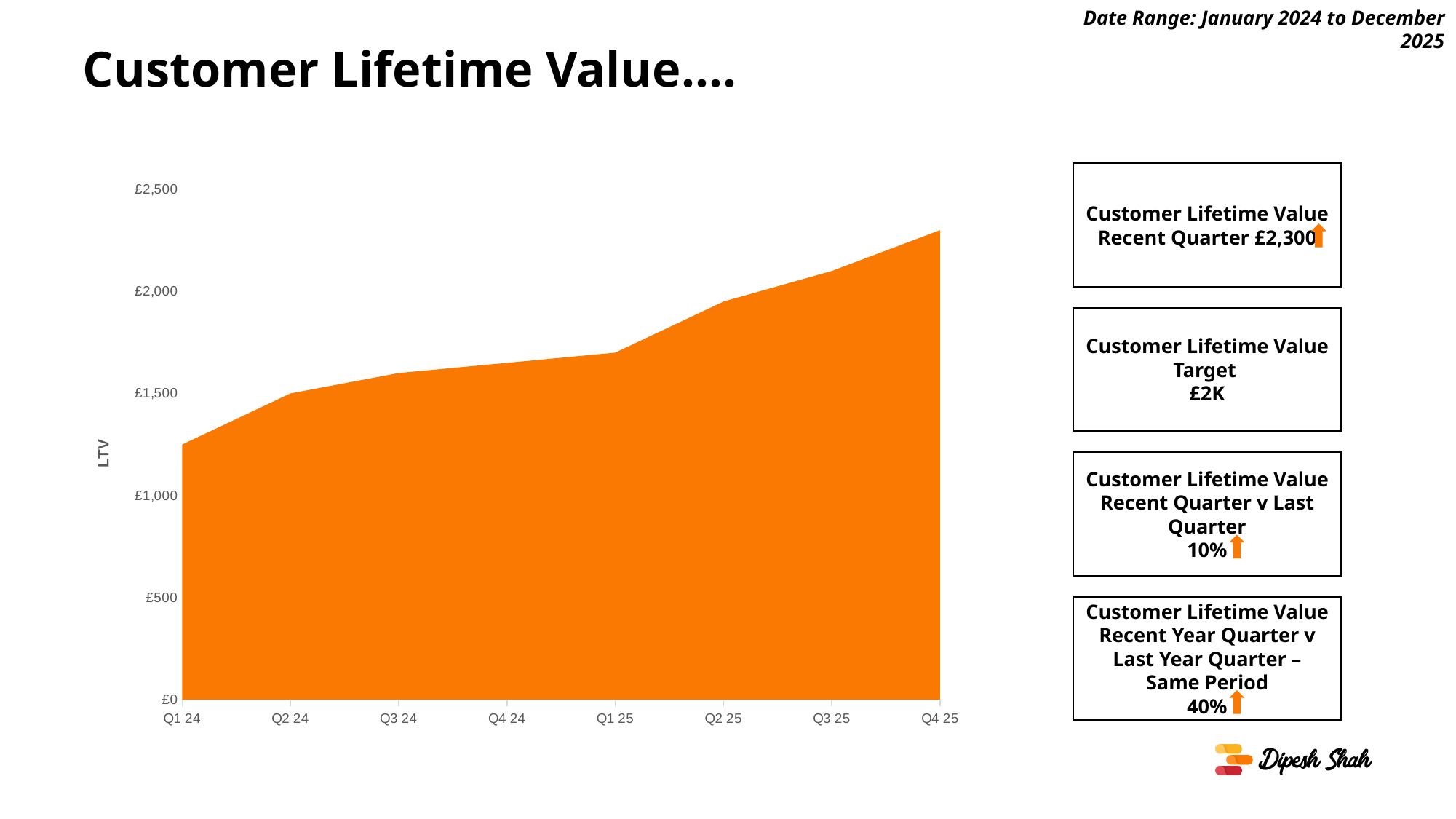
Is the LTV value for Q1 25 greater or less than £1,500? greater Is the LTV value for Q4 24 greater or less than £2,000? less Is the LTV value for Q1 24 greater or less than £1,000? greater Which quarter has the larger LTV, Q2 24 or Q3 25? Q3 25 How many quarters are plotted along the x axis of the chart? 8 What kind of chart is shown on the slide? Area chart Which quarter has the lowest LTV in the chart? Q1 24 What is the label on the y axis of the chart? LTV Do the LTV values rise or fall from Q1 24 to Q4 25? Rise Which quarter has the highest LTV in the chart? Q4 25